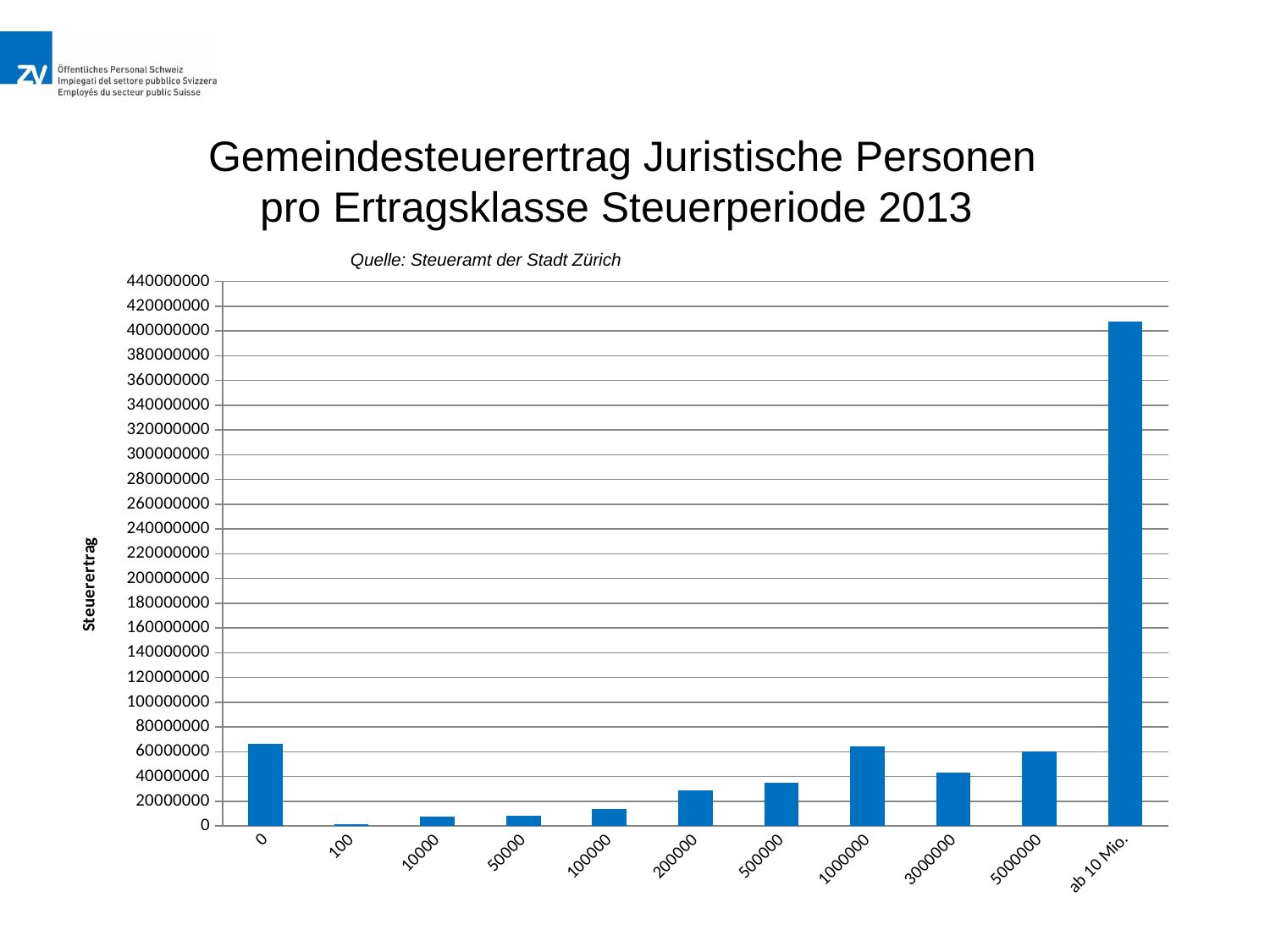
Is the value for the category '100000' greater or less than 20000000? less Is the value for 'ab 10 Mio.' greater or less than 400000000? greater Which has the larger Steuerertrag, the category '1000000' or '3000000'? 1000000 What kind of chart is shown on the slide? bar chart Is the value for the category '500000' greater or less than 40000000? less Which has the larger Steuerertrag, the category '200000' or '500000'? 500000 How many categories (Ertragsklassen) are shown on the x axis? 11 Which category has the lowest Steuerertrag? 100 Which category has the highest Steuerertrag? ab 10 Mio. What is the label of the vertical axis? Steuerertrag